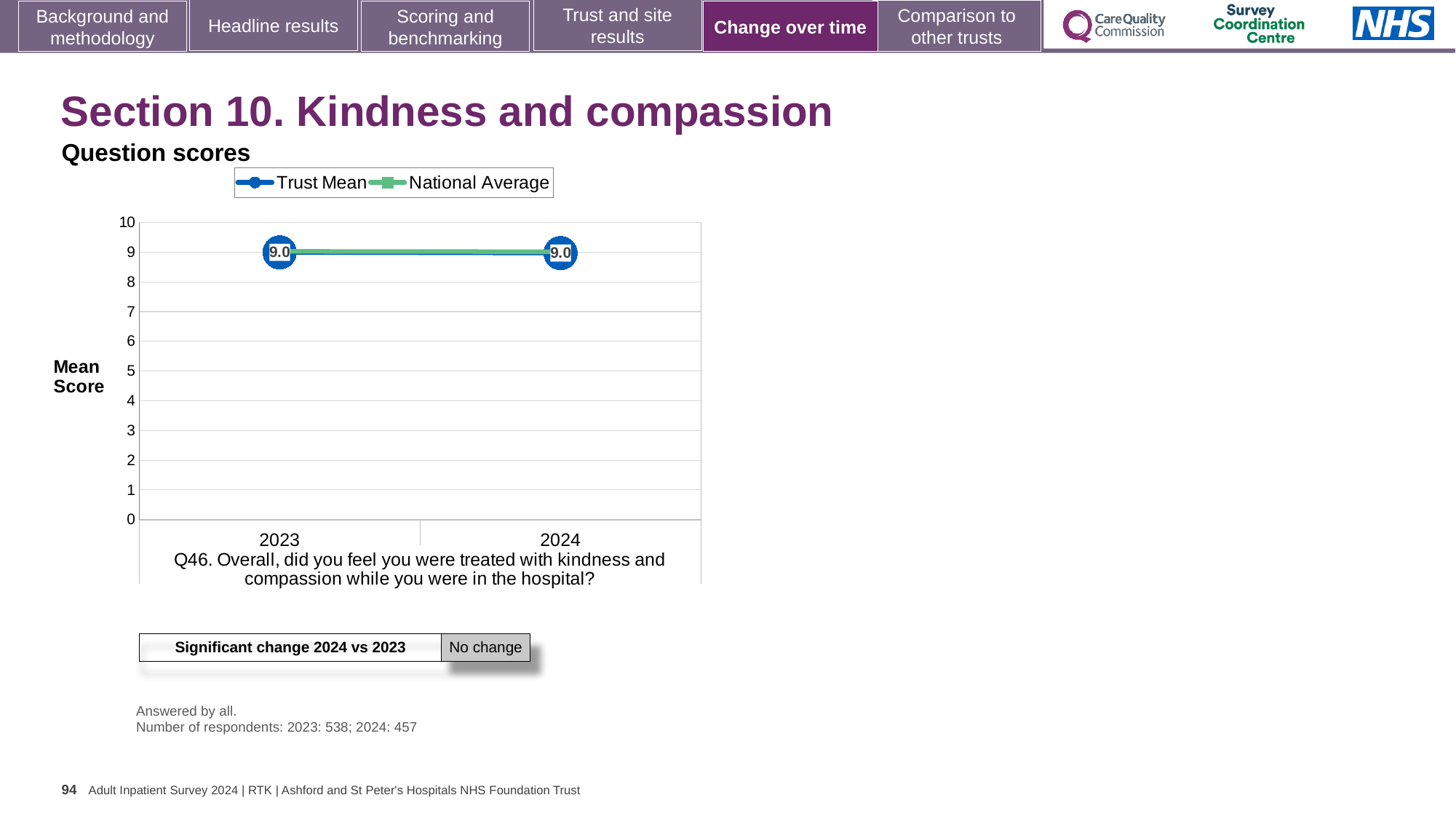
What are the two series named in the chart legend? Trust Mean and National Average What is the maximum value shown on the y axis of the chart? 10 Is the National Average for 2024 greater or less than 8? greater How many series does the chart legend list? 2 What is the label on the y axis of the chart? Mean Score What kind of chart is shown on the slide? Line chart What is the Trust Mean score for 2024? 9.0 Is the Trust Mean for 2023 greater or less than 5? greater What is the Trust Mean score for 2023? 9.0 How many years are plotted on the x axis of the chart? 2 Does the Trust Mean rise, fall or stay the same from 2023 to 2024? Stays the same What is the difference between the Trust Mean for 2024 and the Trust Mean for 2023? 0.0